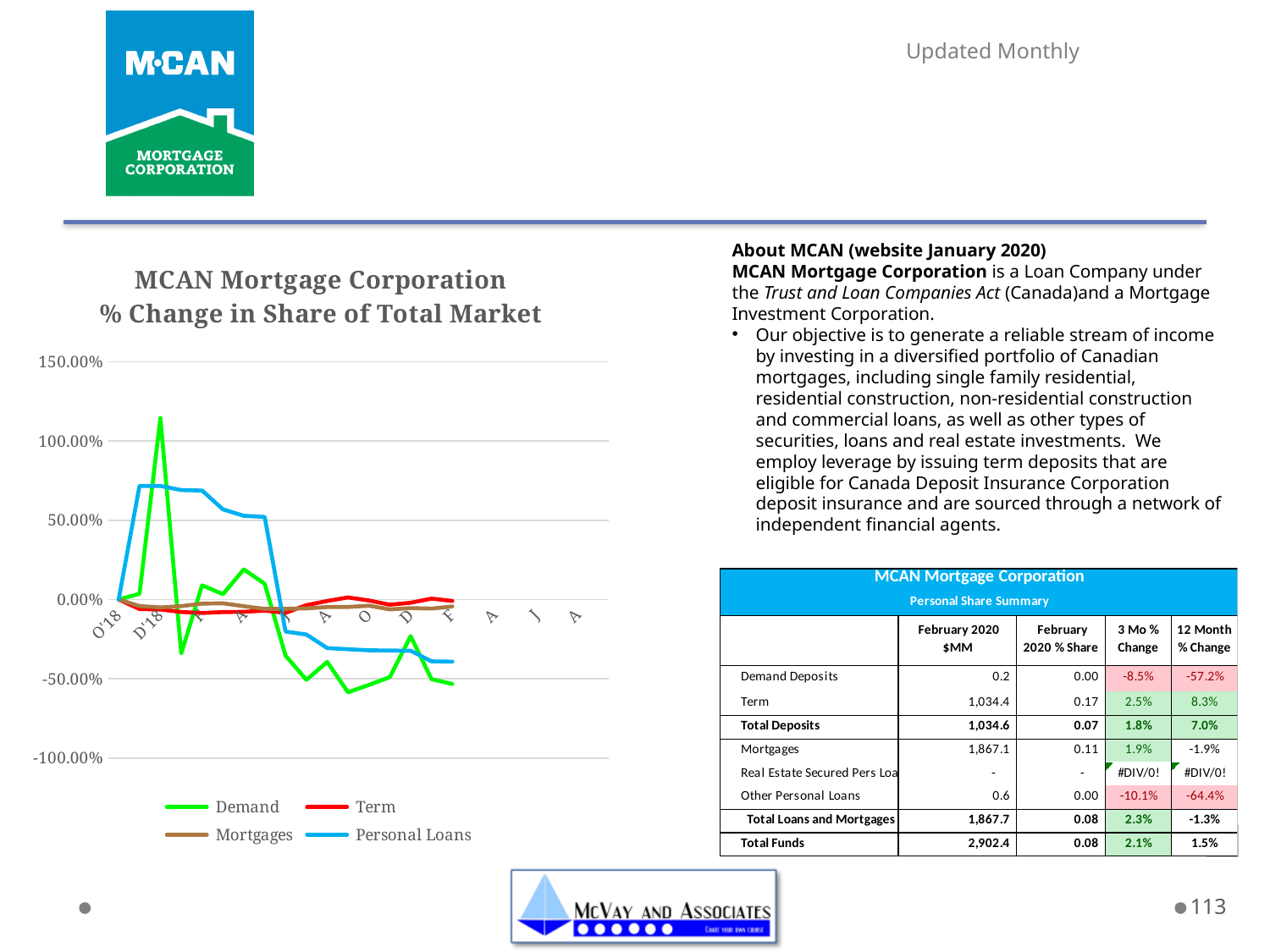
Is the lowest value of the Personal Loans series greater or less than -50.00%? greater Is the peak value of the Demand series greater or less than 100.00%? greater Which series is drawn in green in the chart? Demand Does the Personal Loans series rise or fall overall from its early peak to the end of the x axis? fall What kind of chart is shown on the slide? line chart Is the peak value of the Term series greater or less than 50.00%? less How many series does the chart's legend list? 4 What is the title of the chart? MCAN Mortgage Corporation % Change in Share of Total Market Which series reaches the highest value on the chart? Demand Which series drops to the lowest value on the chart? Demand Which series reaches a higher peak value, Demand or Personal Loans? Demand